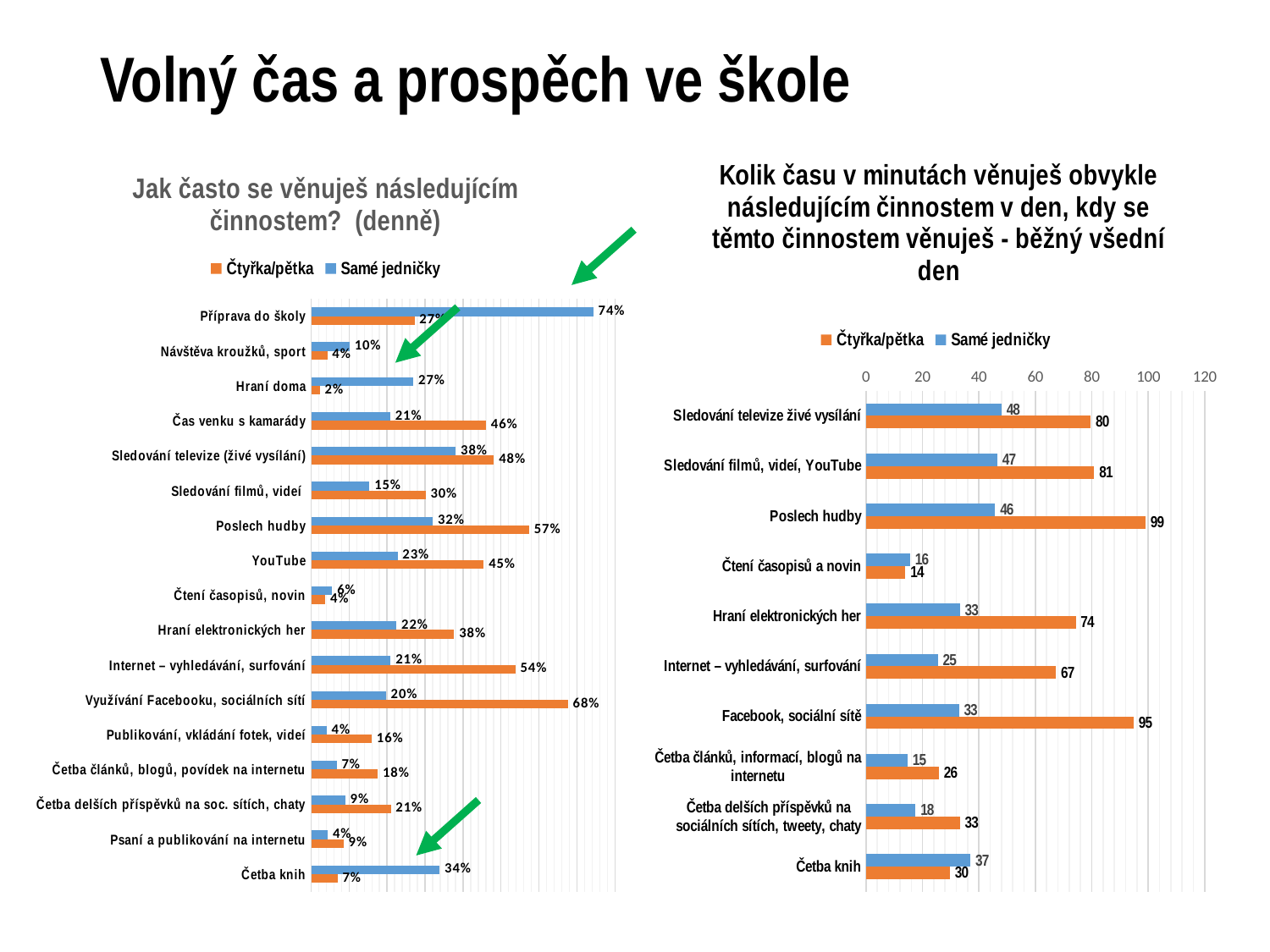
How many categories are shown in the right chart (Kolik času v minutách...)? 10 In the right chart (Kolik času v minutách...), is the Čtyřka/pětka value for Hraní elektronických her greater or less than 60? greater What type of chart is the right chart (Kolik času v minutách...)? Bar chart How many series does the legend of the left chart (Jak často se věnuješ...) list? 2 In the left chart (Jak často se věnuješ...), what is the Čtyřka/pětka value for Využívání Facebooku, sociálních sítí? 68% In the right chart (Kolik času v minutách...), what is the value for Poslech hudby in the Čtyřka/pětka series? 99 Which colour represents the Samé jedničky series in the right chart (Kolik času v minutách...)? Blue In the left chart (Jak často se věnuješ...), which series has the larger value for Četba knih? Samé jedničky In the right chart (Kolik času v minutách...), what is the difference between the Čtyřka/pětka and Samé jedničky values for Facebook, sociální sítě? 62 In the right chart (Kolik času v minutách...), which category has the highest Čtyřka/pětka value? Poslech hudby In the left chart (Jak často se věnuješ...), what is the value for Příprava do školy in the Samé jedničky series? 74% In the left chart (Jak často se věnuješ...), which category has the lowest Čtyřka/pětka value? Hraní doma